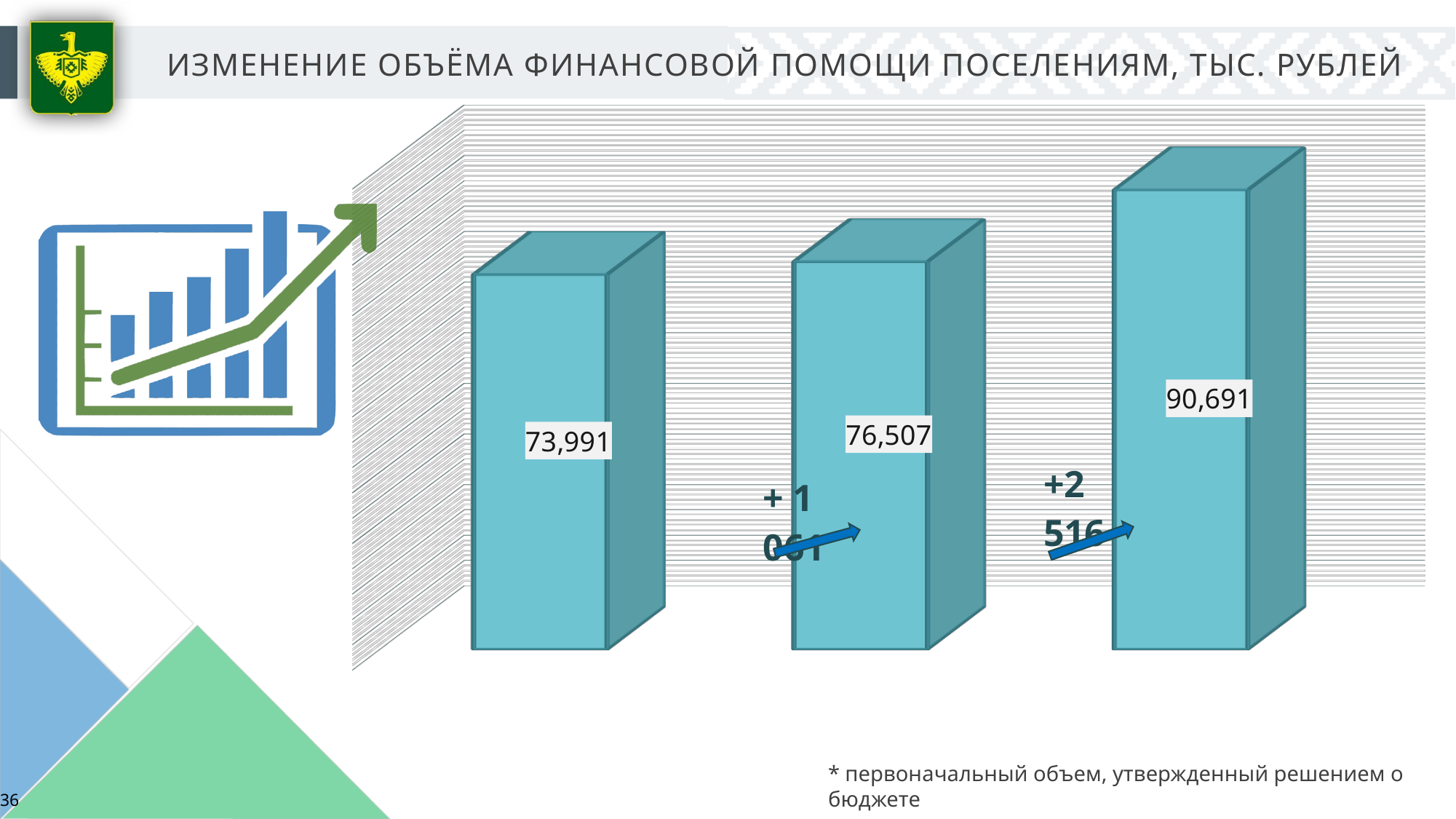
What value is printed on the rightmost bar of the chart? 90,691 What is the difference between the rightmost bar (90,691) and the middle bar (76,507)? 14,184 Do the bar values rise or fall from left to right? rise How many bars are shown in the chart? 3 What kind of chart is shown on the slide? bar chart Which is larger, the value of the middle bar or the value of the leftmost bar? the middle bar Which bar has the highest value: the left, middle or right one? the right one What is the difference between the rightmost bar (90,691) and the leftmost bar (73,991)? 16,700 What is the difference between the middle bar (76,507) and the leftmost bar (73,991)? 2,516 What value is printed on the middle bar of the chart? 76,507 Which bar has the lowest value: the left, middle or right one? the left one What value is printed on the leftmost bar of the chart? 73,991